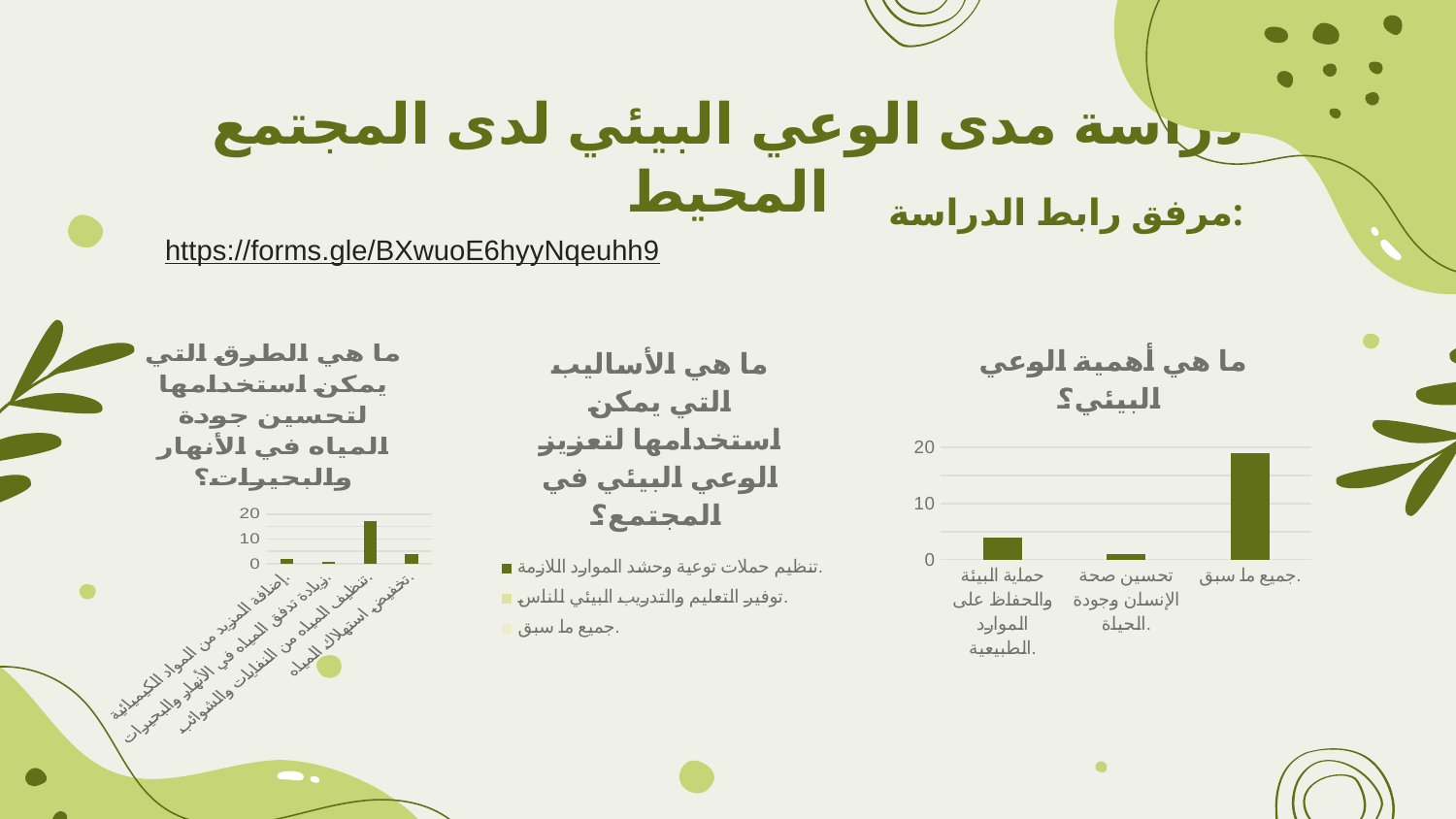
How many entries does the legend list for the chart titled "ما هي الأساليب التي يمكن استخدامها لتعزيز الوعي البيئي في المجتمع؟"? 3 In the bottom-left chart titled "ما هي الطرق التي يمكن استخدامها لتحسين جودة المياه في الأنهار والبحيرات؟", is the tallest bar greater or less than 10? greater In the chart titled "ما هي أهمية الوعي البيئي؟", is the value for "حماية البيئة والحفاظ على الموارد الطبيعية" greater or less than 10? less In the chart titled "ما هي أهمية الوعي البيئي؟", which category has the highest value? جميع ما سبق What kind of chart is the one at the bottom left, titled "ما هي الطرق التي يمكن استخدامها لتحسين جودة المياه في الأنهار والبحيرات؟"? bar chart What is the highest value shown on the vertical axis of the chart titled "ما هي أهمية الوعي البيئي؟"? 20 What kind of chart is the one titled "ما هي أهمية الوعي البيئي؟"? bar chart What is the highest value shown on the vertical axis of the bottom-left chart titled "ما هي الطرق التي يمكن استخدامها لتحسين جودة المياه في الأنهار والبحيرات؟"? 20 In the chart titled "ما هي أهمية الوعي البيئي؟", is the value for "جميع ما سبق" greater or less than 10? greater In the chart titled "ما هي أهمية الوعي البيئي؟", which is larger: the value for "حماية البيئة والحفاظ على الموارد الطبيعية" or the value for "تحسين صحة الإنسان وجودة الحياة"? حماية البيئة والحفاظ على الموارد الطبيعية In the chart titled "ما هي أهمية الوعي البيئي؟", which category has the lowest value? تحسين صحة الإنسان وجودة الحياة How many categories are shown in the chart titled "ما هي أهمية الوعي البيئي؟"? 3